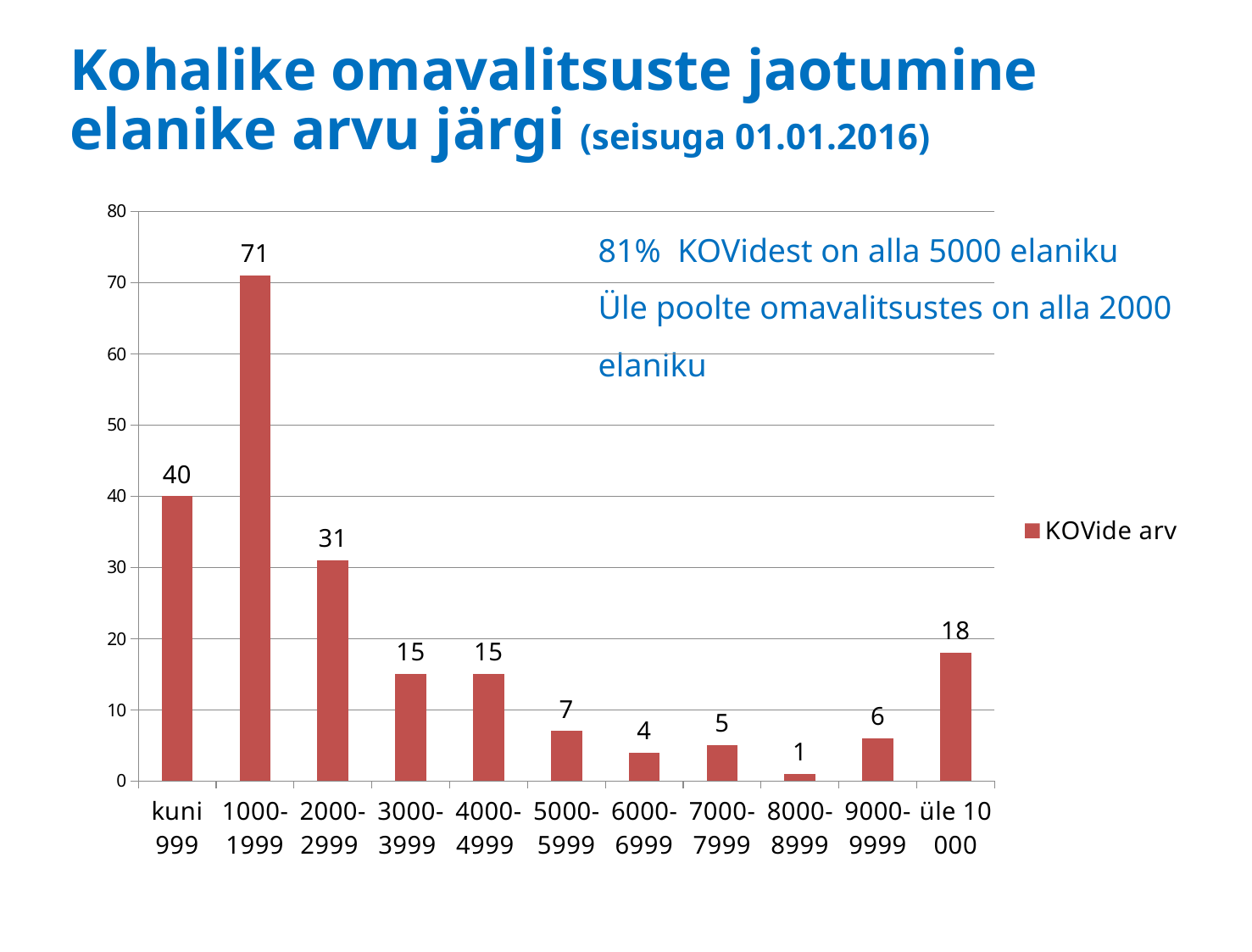
What is the name of the series in the legend? KOVide arv What is the value for the 'kuni 999' category? 40 What is the value for the 'üle 10 000' category? 18 What is the value for the 1000-1999 category? 71 How many series does the legend list? 1 What is the difference between the values for 1000-1999 and 2000-2999? 40 What kind of chart is shown on the slide? bar chart How many categories are shown on the x axis? 11 Is the value for 2000-2999 greater or less than 20? greater Which category has the lowest value? 8000-8999 Which is larger, the value for 5000-5999 or the value for 9000-9999? 5000-5999 Which category has the highest value? 1000-1999